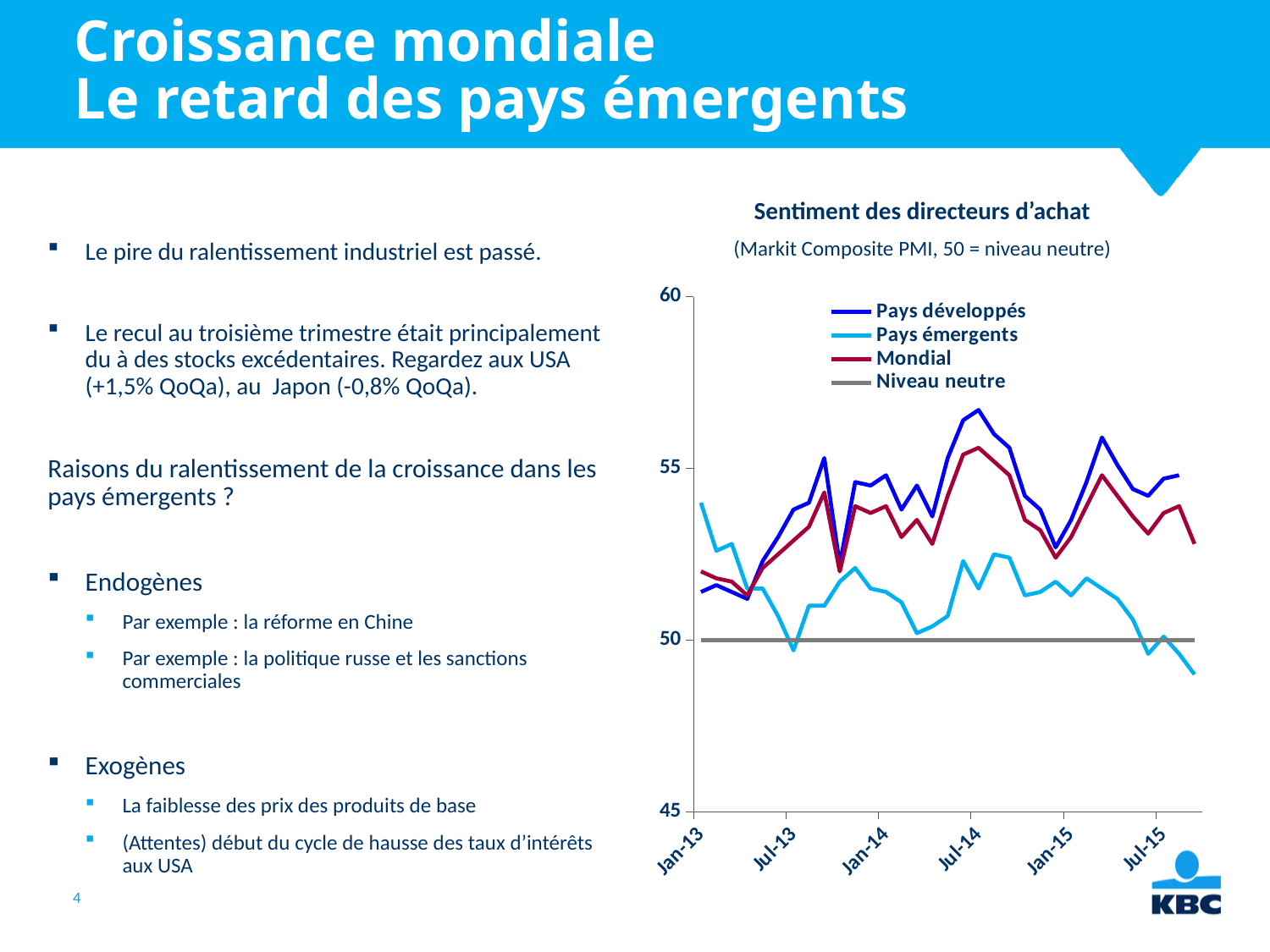
Does the Pays émergents line rise or fall between Jan-15 and the end of the series? fall Which series is lower in Jan-15, Mondial or Pays émergents? Pays émergents Is the value for Mondial in Jan-15 greater or less than 50? greater Which series is drawn as a flat grey line? Niveau neutre Is the value for Pays émergents at the end of the series (after Jul-15) greater or less than 50? less Is the value for Pays développés in Jul-14 greater or less than 55? greater Which series is higher in Jul-14, Pays développés or Pays émergents? Pays développés What kind of chart is shown on the slide? line chart How many series does the chart legend list? 4 At what value is the Niveau neutre line drawn? 50 What is the title of the chart? Sentiment des directeurs d'achat